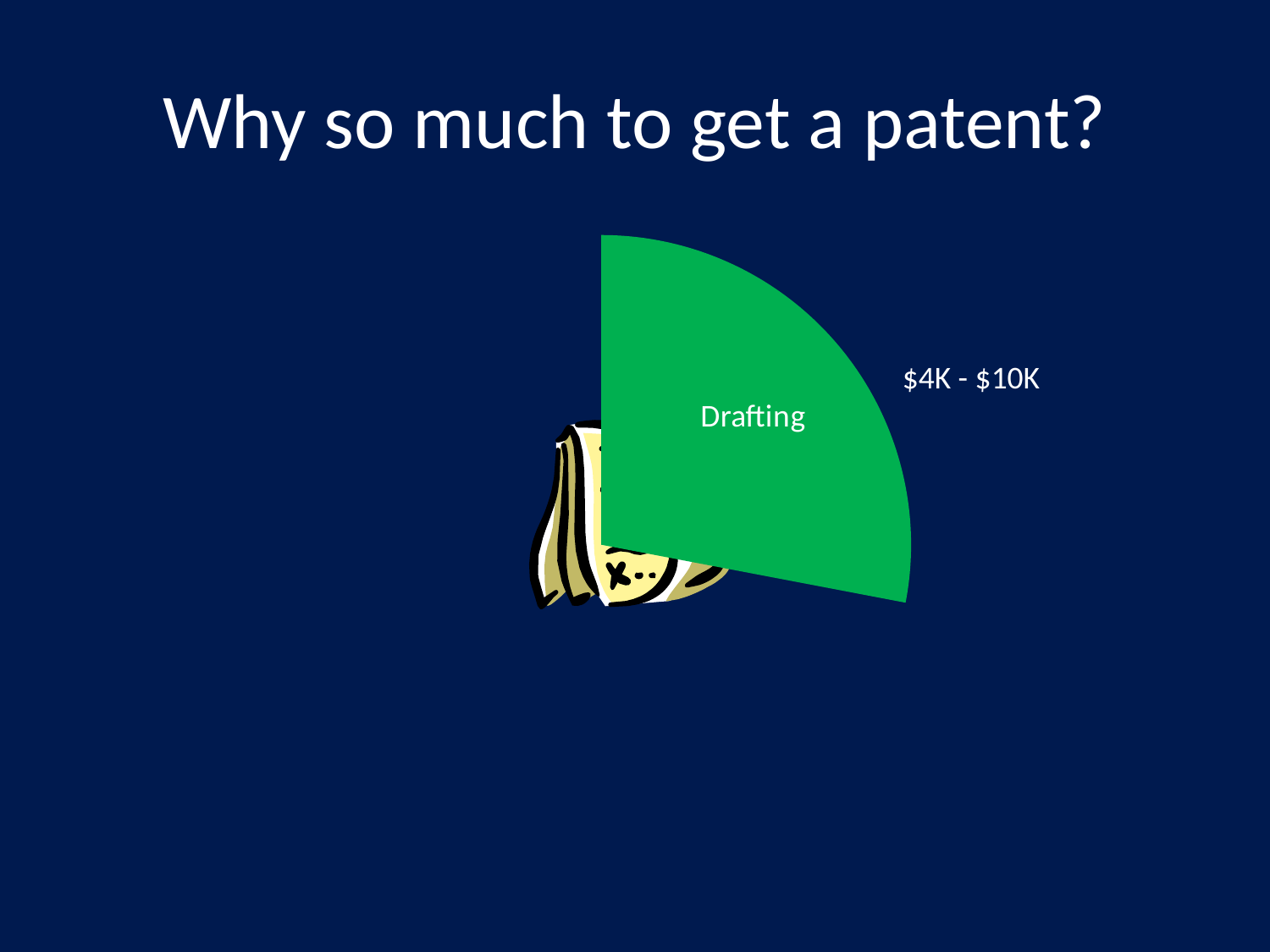
What kind of chart is shown on the slide? pie chart What cost range is shown for the Drafting slice? $4K - $10K How many slices are visible in the pie chart? 1 What colour is the Drafting slice? green What is the label of the only slice shown in the pie chart? Drafting What is the title of the slide containing the chart? Why so much to get a patent?